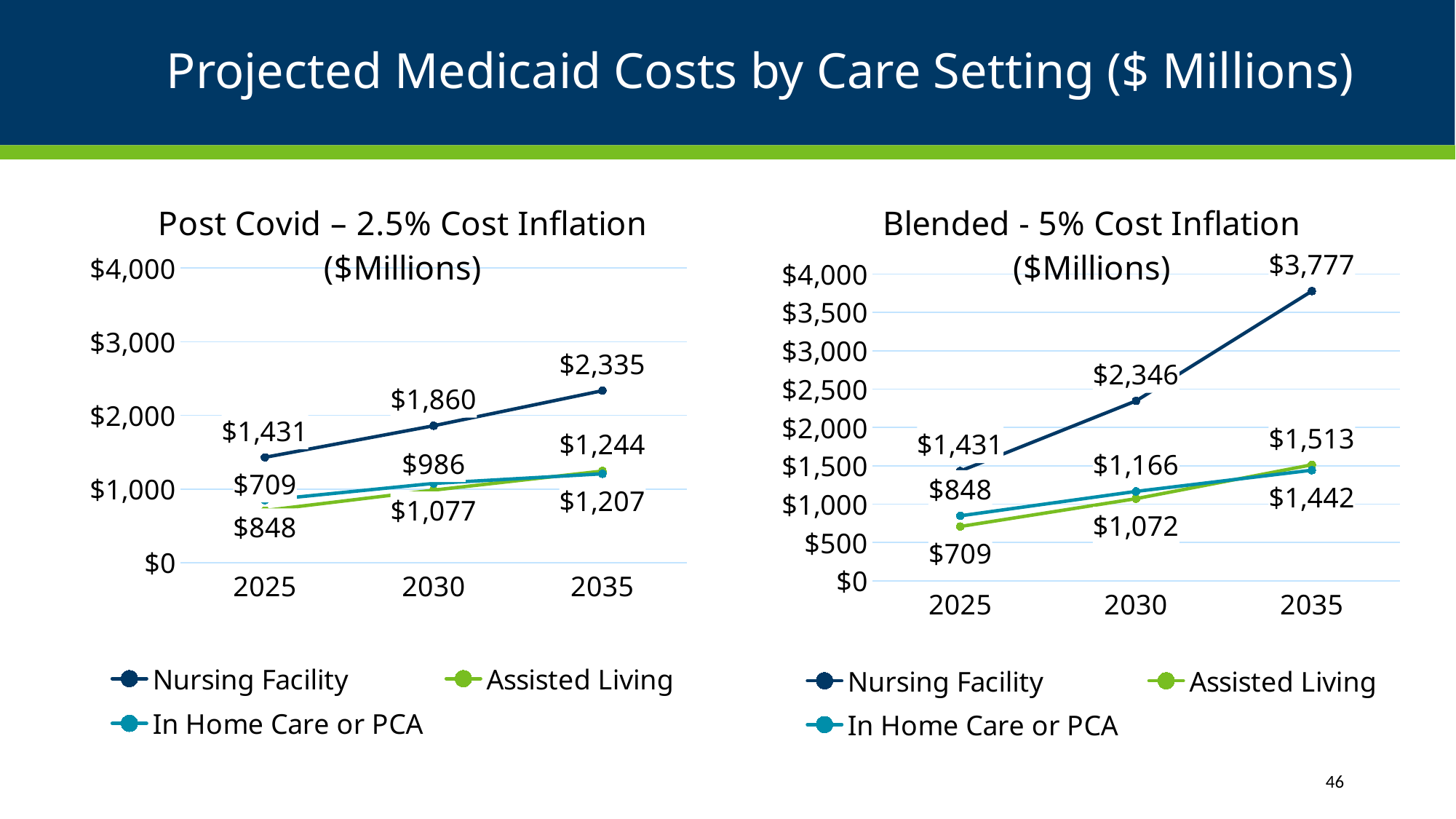
In the right chart (Blended - 5% Cost Inflation), what is the projected Nursing Facility cost in 2035? $3,777 What kind of chart is the right chart (Blended - 5% Cost Inflation)? Line chart In the right chart (Blended - 5% Cost Inflation), which care setting has the highest projected cost in 2035? Nursing Facility In the right chart (Blended - 5% Cost Inflation), which is larger in 2035: Assisted Living or In Home Care or PCA? Assisted Living In the left chart (Post Covid – 2.5% Cost Inflation), what is the projected Nursing Facility cost in 2035? $2,335 How many series does the legend of the left chart list? 3 In the left chart (Post Covid – 2.5% Cost Inflation), what is the difference between the Nursing Facility values for 2030 and 2025? $429 In the right chart (Blended - 5% Cost Inflation), what is the In Home Care or PCA value for 2025? $848 In the left chart (Post Covid – 2.5% Cost Inflation), what is the Nursing Facility value for 2025? $1,431 In the right chart (Blended - 5% Cost Inflation), by how much does the Nursing Facility cost increase from 2025 to 2035? $2,346 In the right chart (Blended - 5% Cost Inflation), what is the Assisted Living value for 2030? $1,072 In the right chart (Blended - 5% Cost Inflation), does the Nursing Facility line rise or fall from 2025 to 2035? Rises